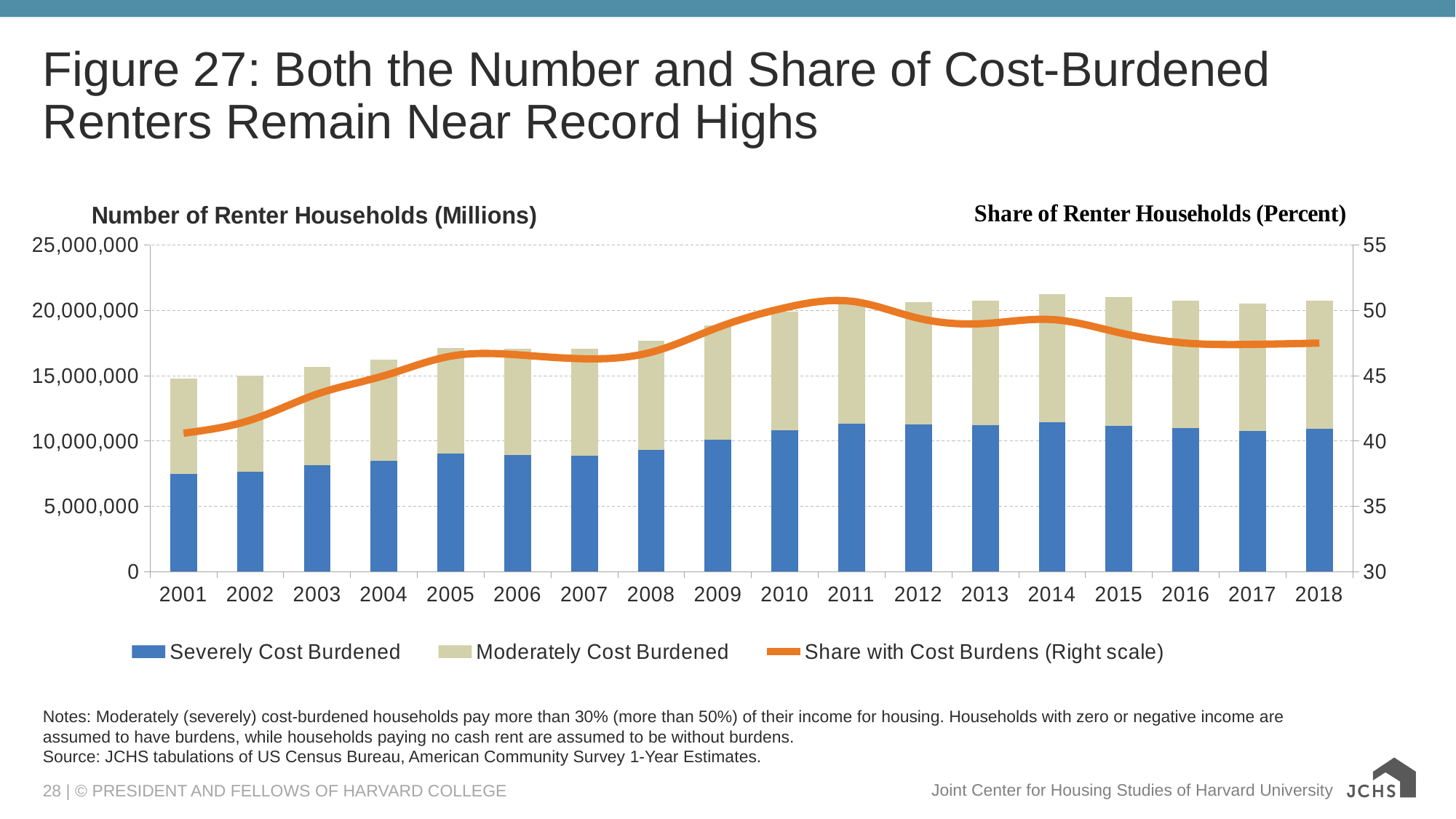
What is the label of the left vertical axis of the chart? Number of Renter Households (Millions) How many series does the chart's legend list? 3 What kind of chart is shown on the slide? A combination chart with stacked bars and a line Is the Share with Cost Burdens value for 2001 greater or less than 45? less Is the total height of the stacked bar for 2014 greater or less than 20,000,000? greater Does the Share with Cost Burdens line rise or fall from 2001 to 2011? rise Is the Severely Cost Burdened value for 2011 greater or less than 10,000,000? greater Which series in the chart is plotted on the right scale? Share with Cost Burdens How many years are shown along the x axis of the chart? 18 In which year does the Share with Cost Burdens line reach its highest point? 2011 In which year is the total stacked bar (all cost-burdened renters) the lowest? 2001